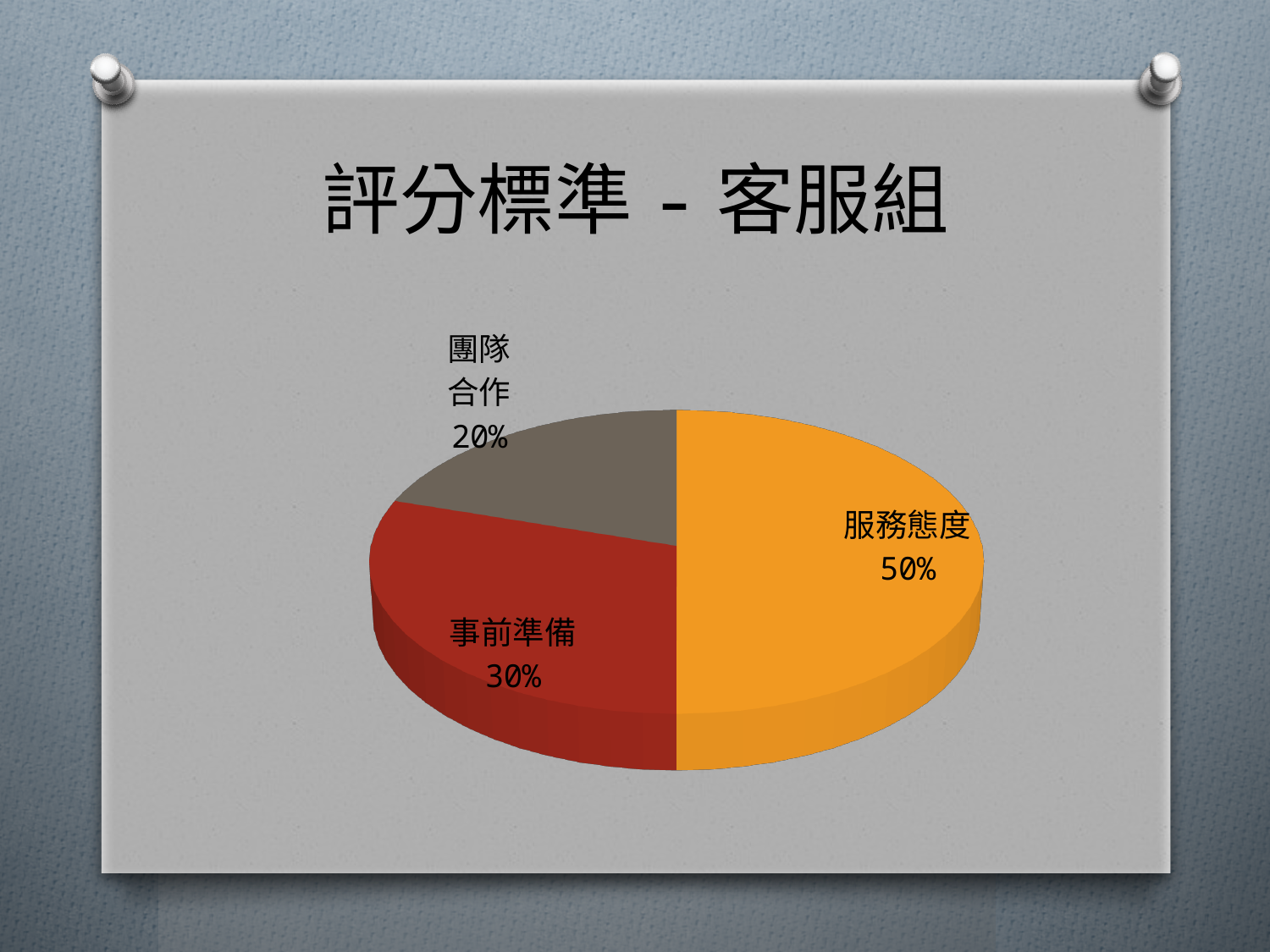
What is the value for 事前準備? 30% What is the difference between the shares of 服務態度 and 事前準備? 20% What kind of chart is shown on the slide? pie chart What is the value for 團隊合作? 20% How many slices does the pie chart have? 3 What colour is the 服務態度 slice? orange What is the title of the slide containing the chart? 評分標準 - 客服組 Which is larger, the share of 事前準備 or the share of 團隊合作? 事前準備 Which category has the smallest share of the pie? 團隊合作 Which category has the largest share of the pie? 服務態度 What is the difference between the shares of 事前準備 and 團隊合作? 10% What is the value for 服務態度? 50%